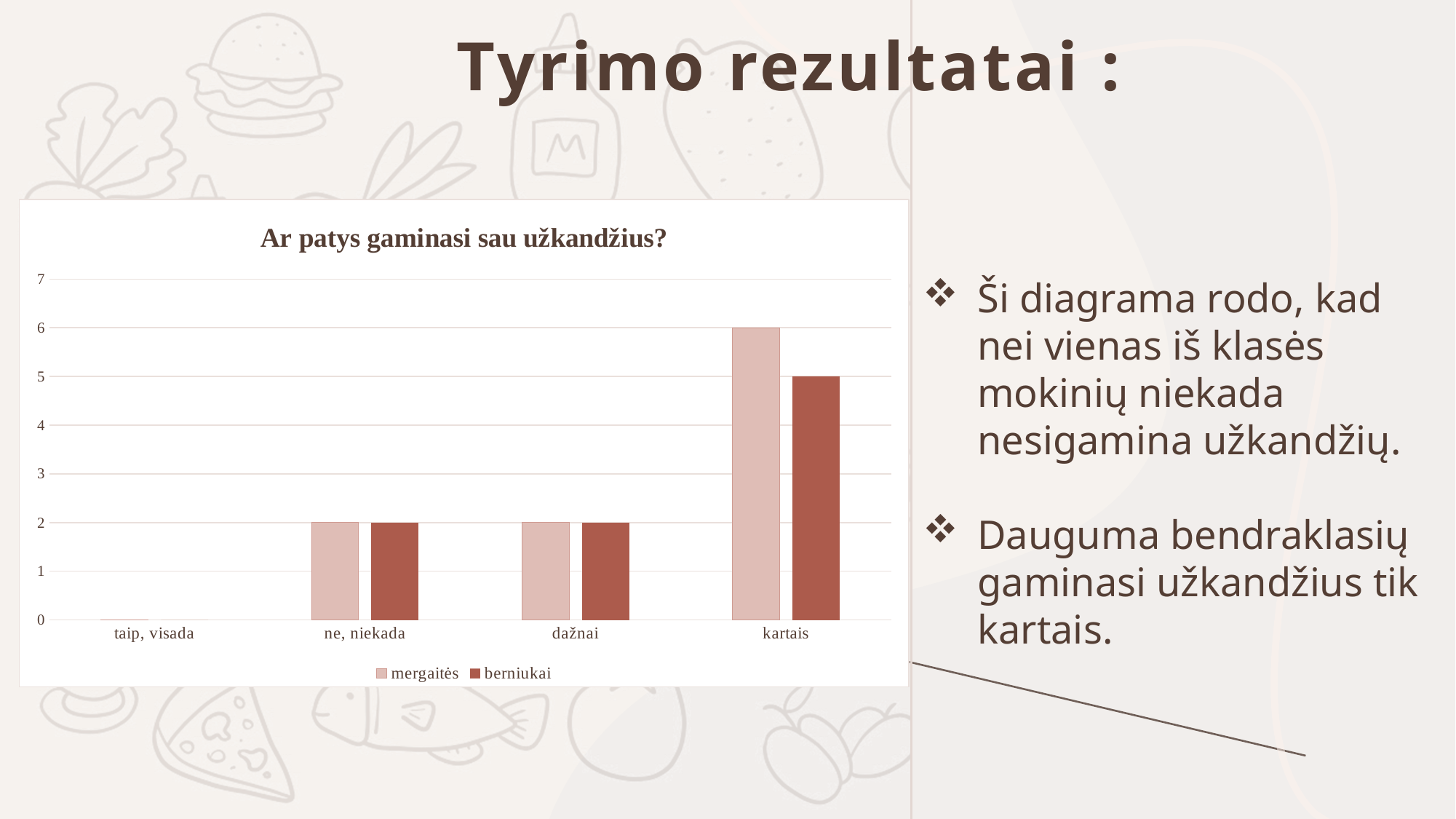
What is the value for mergaitės in the category ne, niekada? 2 Which category has the highest value for mergaitės? kartais What is the value for berniukai in the category dažnai? 2 What is the title of the chart? Ar patys gaminasi sau užkandžius? What kind of chart is shown on the slide? bar chart How many series does the legend list? 2 What is the value for mergaitės in the category kartais? 6 What is the difference between the mergaitės and berniukai values in the category kartais? 1 In the category kartais, which series has the larger value, mergaitės or berniukai? mergaitės How many categories are shown on the x axis? 4 What is the value for berniukai in the category kartais? 5 Which category has the lowest value for berniukai? taip, visada